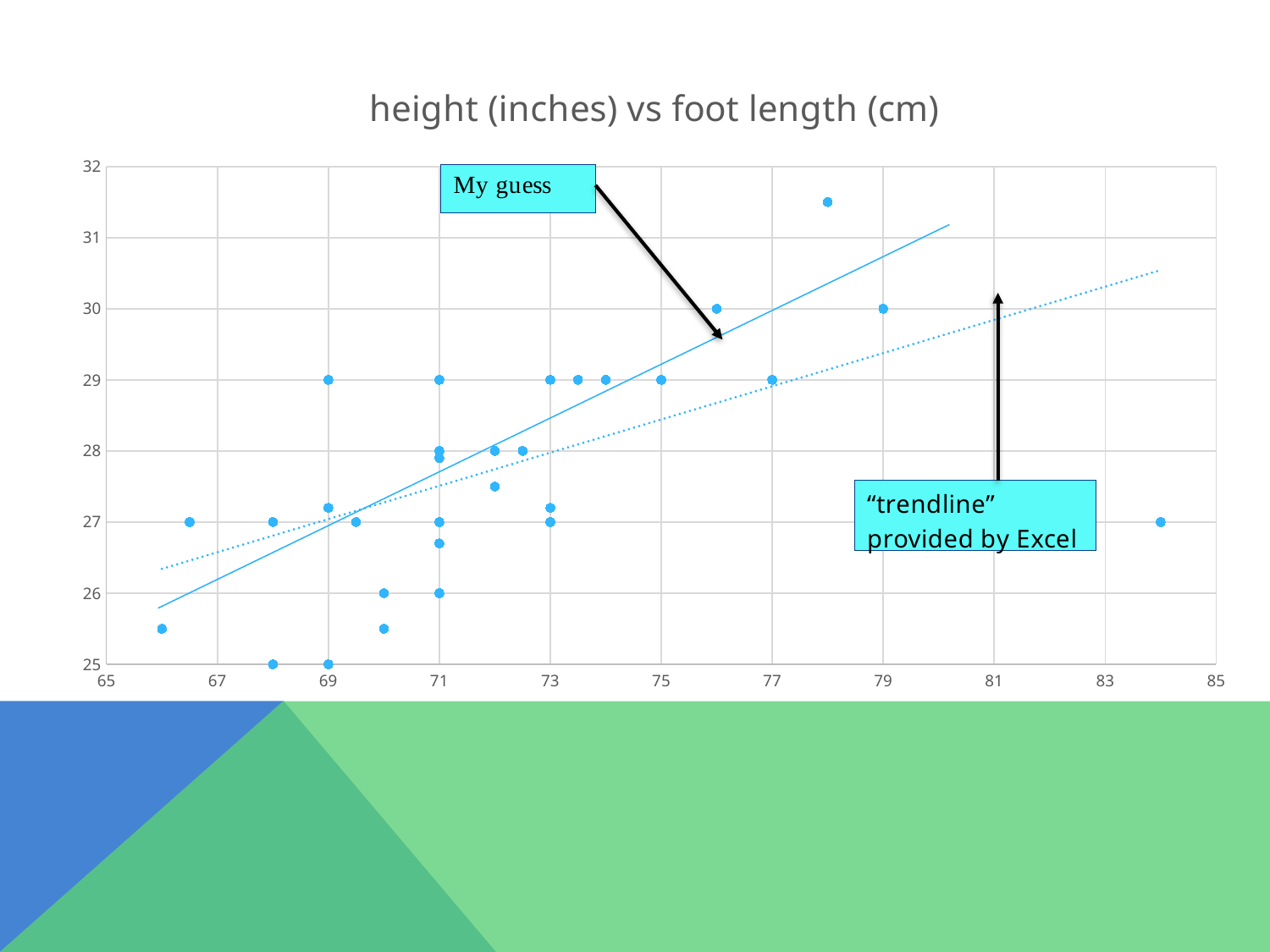
Do foot lengths generally rise or fall as height increases along the x axis? rise Is the highest foot length plotted on the chart greater or less than 31? greater Is the foot length of the rightmost point on the chart greater or less than 28? less Which has the larger foot length, the point at height 79 or the point at height 77? the point at height 79 Is the largest height value plotted greater or less than 83? greater What foot length is plotted for the point at height 79? 30 What is the difference in foot length between the point at height 79 and the point at height 77? 1 What foot length is plotted for the point at height 75? 29 What kind of chart is shown on the slide? scatter plot What foot length is plotted for the point at height 77? 29 What is the title of the chart? height (inches) vs foot length (cm) What is the lowest value shown on the y axis? 25